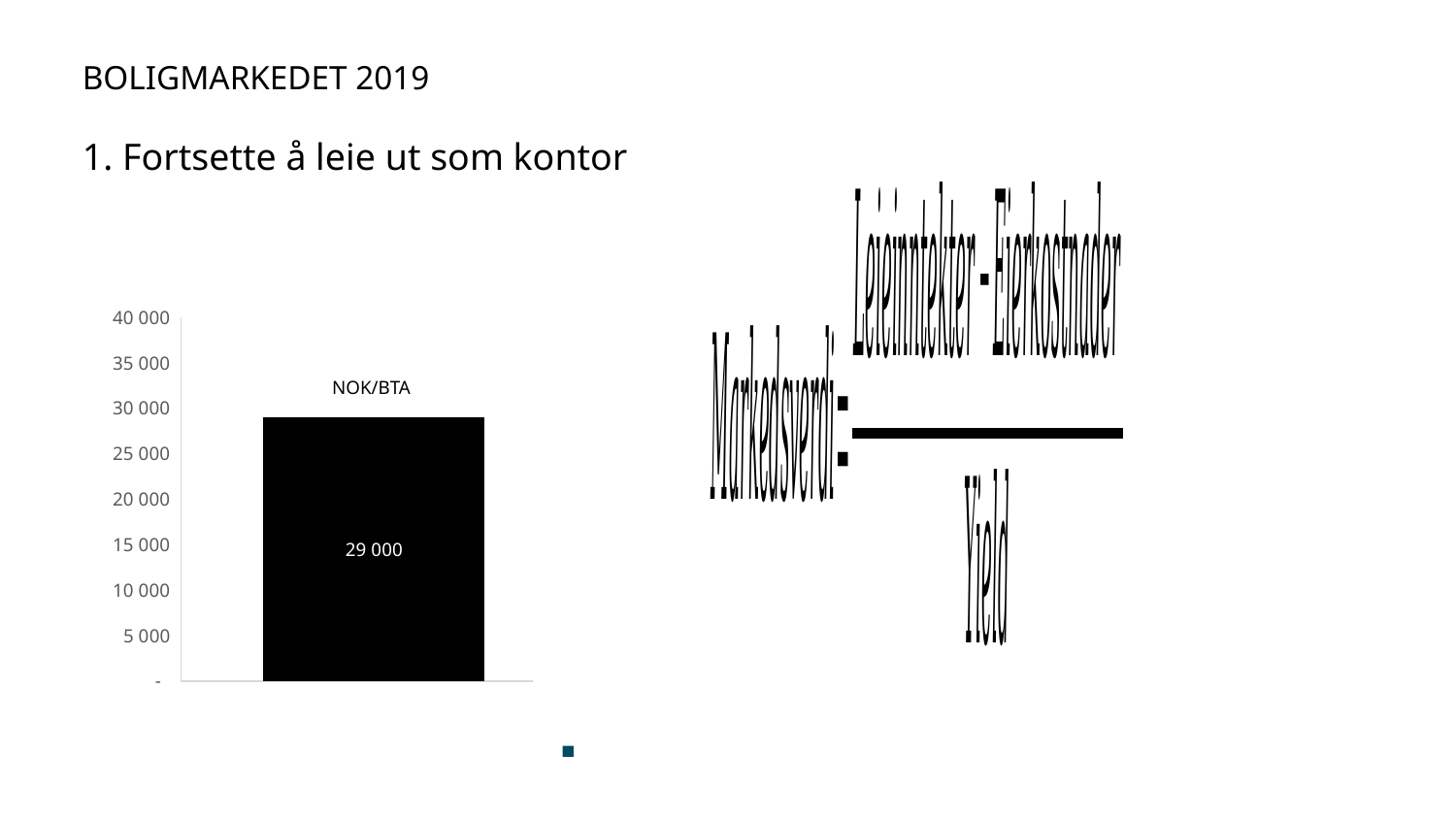
What kind of chart is shown on the slide? bar chart Is the value of the bar greater or less than 30 000? less What is the highest value shown on the chart's vertical axis? 40 000 What label is printed above the bar in the chart? NOK/BTA How many bars are plotted in the chart? 1 What value is printed on the bar in the chart? 29 000 Is the value of the bar greater or less than 25 000? greater